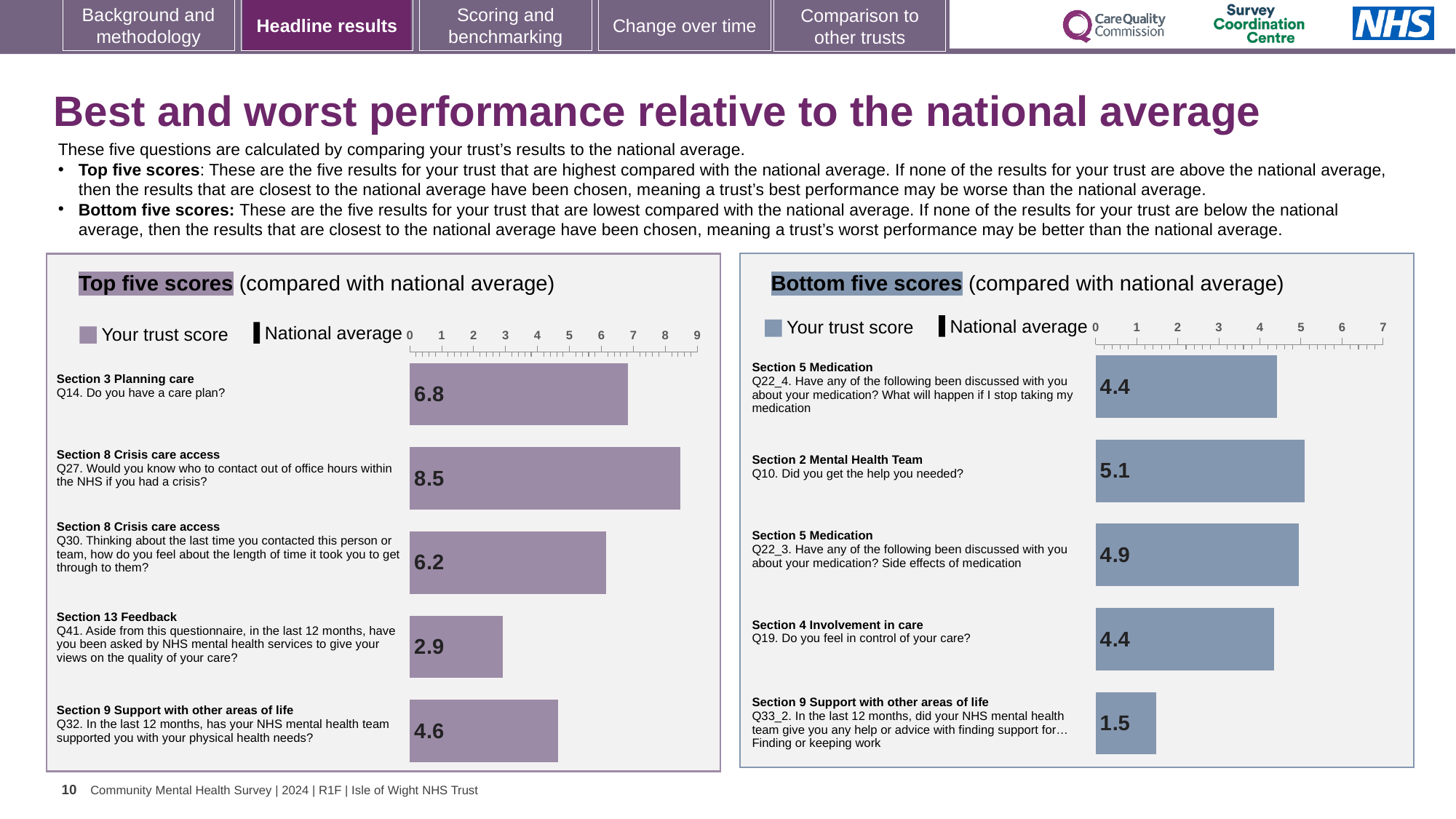
What type of chart is the Bottom five scores chart? Bar chart In the Top five scores chart, which question has the highest trust score? Q27 (Section 8 Crisis care access) How many bars are plotted in the Top five scores chart? 5 In the Bottom five scores chart, which question has the lowest trust score? Q33_2 (Section 9 Support with other areas of life) In the Bottom five scores chart, which question has the highest trust score? Q10 (Section 2 Mental Health Team) In the Top five scores chart, what is the trust score for Q14 (Do you have a care plan?)? 6.8 In the Bottom five scores chart, which has the larger trust score: Q10 or Q22_3? Q10 In the Bottom five scores chart, what is the trust score for Q33_2 (help or advice with finding support for finding or keeping work)? 1.5 In the Top five scores chart, which question has the lowest trust score? Q41 (Section 13 Feedback) In the Top five scores chart, what is the difference between the trust scores for Q27 and Q41? 5.6 In the Bottom five scores chart, what is the difference between the trust scores for Q10 and Q33_2? 3.6 In the Top five scores chart, what is the trust score for Q27 (Would you know who to contact out of office hours within the NHS if you had a crisis?)? 8.5